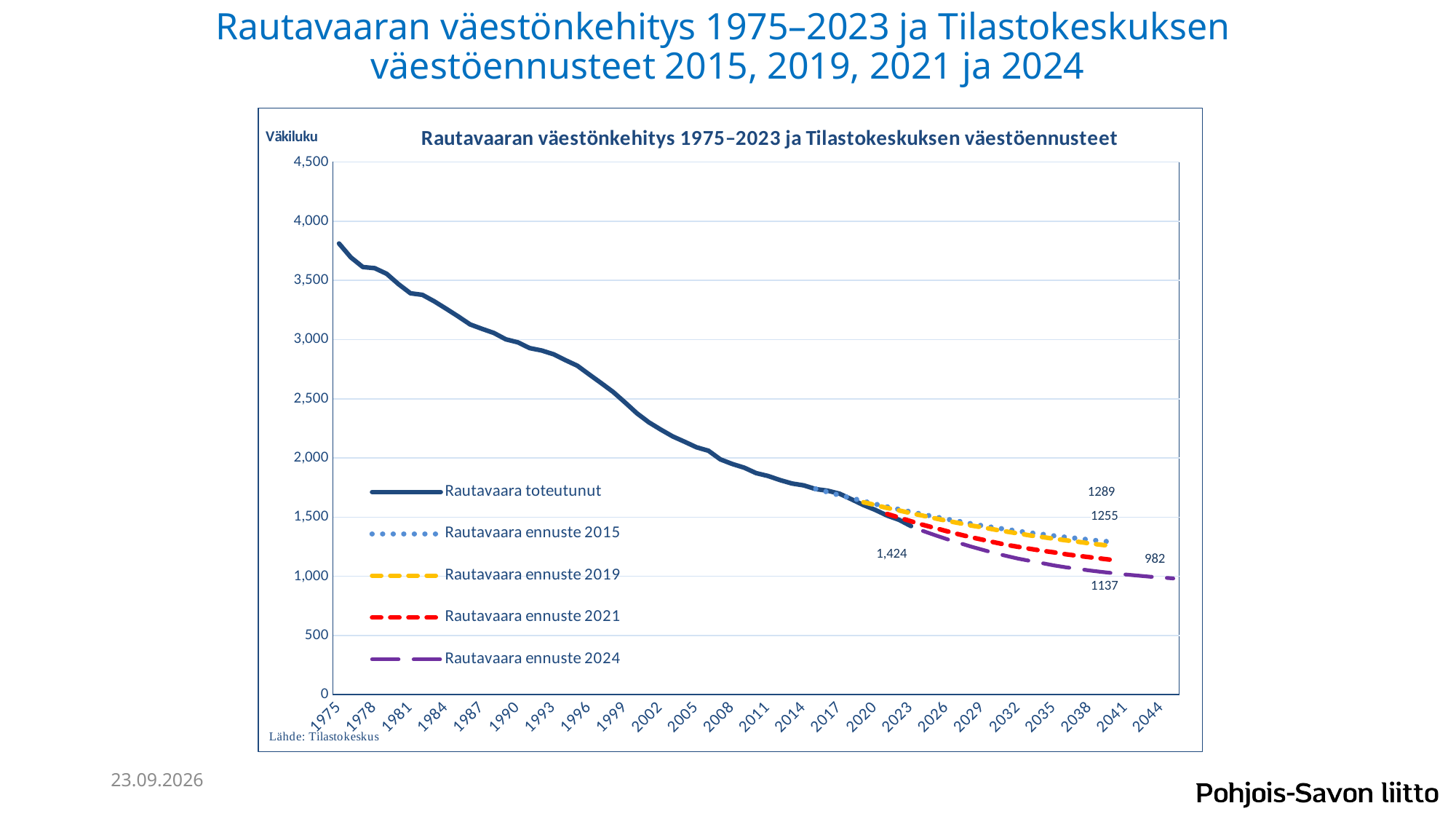
Which forecast series ends at a higher value, Rautavaara ennuste 2015 or Rautavaara ennuste 2021? Rautavaara ennuste 2015 What is the difference between the labelled end values of the ennuste 2015 series (1289) and the ennuste 2024 series (982)? 307 What is the labelled end value of the Rautavaara ennuste 2015 series? 1289 What is the labelled end value of the Rautavaara ennuste 2021 series? 1137 Is the value of the Rautavaara toteutunut series in 1975 greater or less than 3,500? greater What is the labelled end value of the Rautavaara ennuste 2024 series? 982 What is the labelled final value of the Rautavaara toteutunut series in 2023? 1,424 What kind of chart is shown on the slide? line chart Which forecast series ends at the lowest value? Rautavaara ennuste 2024 Does the Rautavaara toteutunut series rise or fall from 1975 to 2023? fall What is the labelled end value of the Rautavaara ennuste 2019 series? 1255 How many series does the legend list? 5